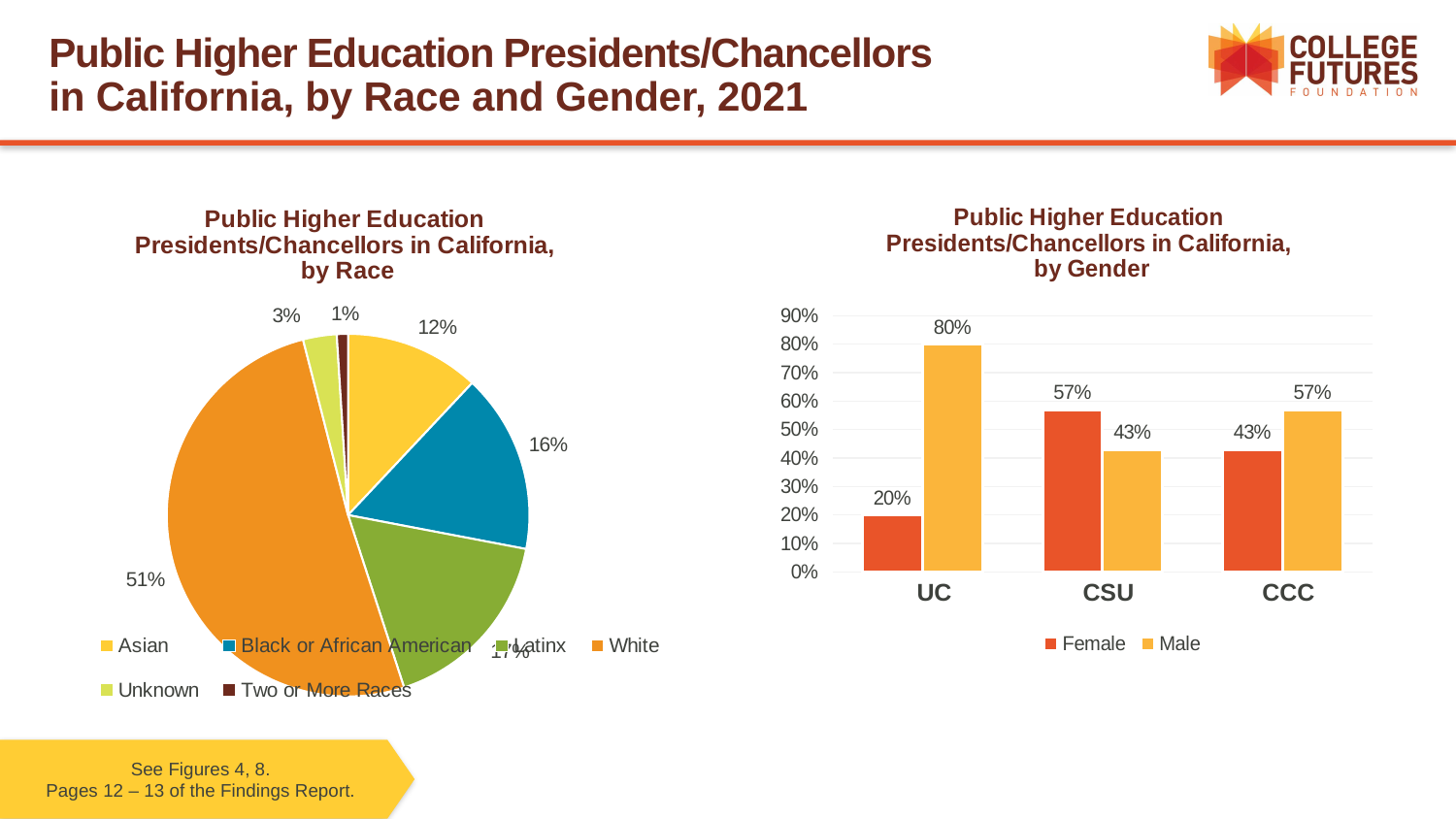
In the 'by Gender' bar chart, what is the Female value for CSU? 57% What kind of chart is the 'by Gender' chart on the right? bar chart In the 'by Race' pie chart, how many categories does the legend list? 6 In the 'by Gender' bar chart, what is the Female value for CCC? 43% In the 'by Race' pie chart, which category has the smallest slice? Two or More Races In the 'by Race' pie chart, what share are Black or African American? 16% In the 'by Gender' bar chart, what is the difference between the Male and Female values for UC? 60% In the 'by Gender' bar chart, what percentage of UC presidents/chancellors are male? 80% In the 'by Gender' bar chart, which system has the lowest Female percentage? UC In the 'by Race' pie chart, what share of presidents/chancellors are White? 51% In the 'by Gender' bar chart, is the Female value for CSU larger or smaller than the Male value for CSU? larger In the 'by Gender' bar chart, how many series does the legend list? 2